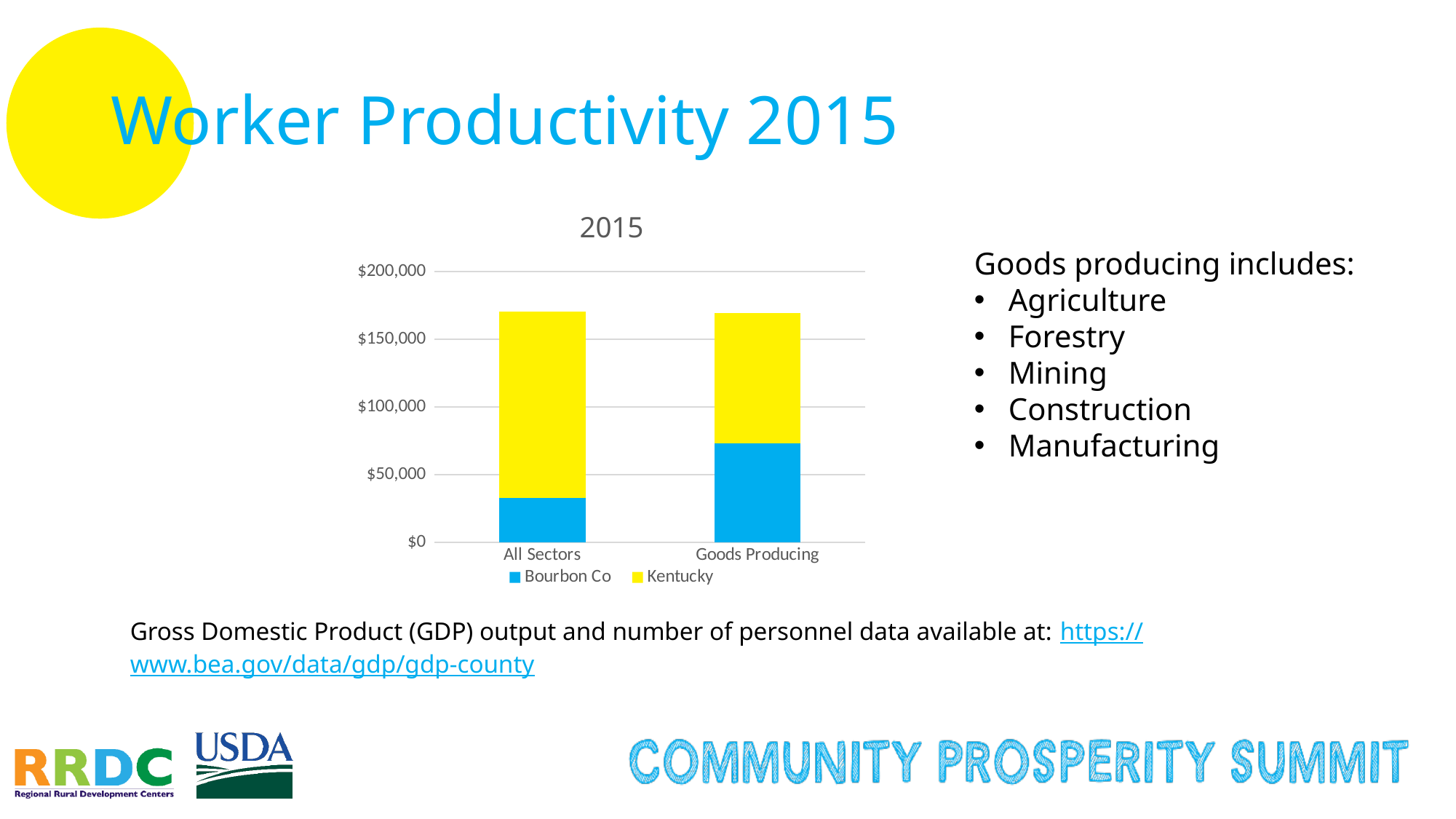
What is the title of the chart? 2015 Which colour represents Kentucky in the chart? Yellow For Kentucky, which category has the larger segment: All Sectors or Goods Producing? All Sectors Is the total stacked value for Goods Producing greater or less than $200,000? less Is the Bourbon Co value for All Sectors greater or less than $50,000? less What kind of chart is shown on the slide? Stacked bar chart Is the total stacked value for All Sectors greater or less than $150,000? greater For Bourbon Co, which category has the higher value: All Sectors or Goods Producing? Goods Producing How many series does the chart legend list? 2 How many categories are shown on the x axis of the chart? 2